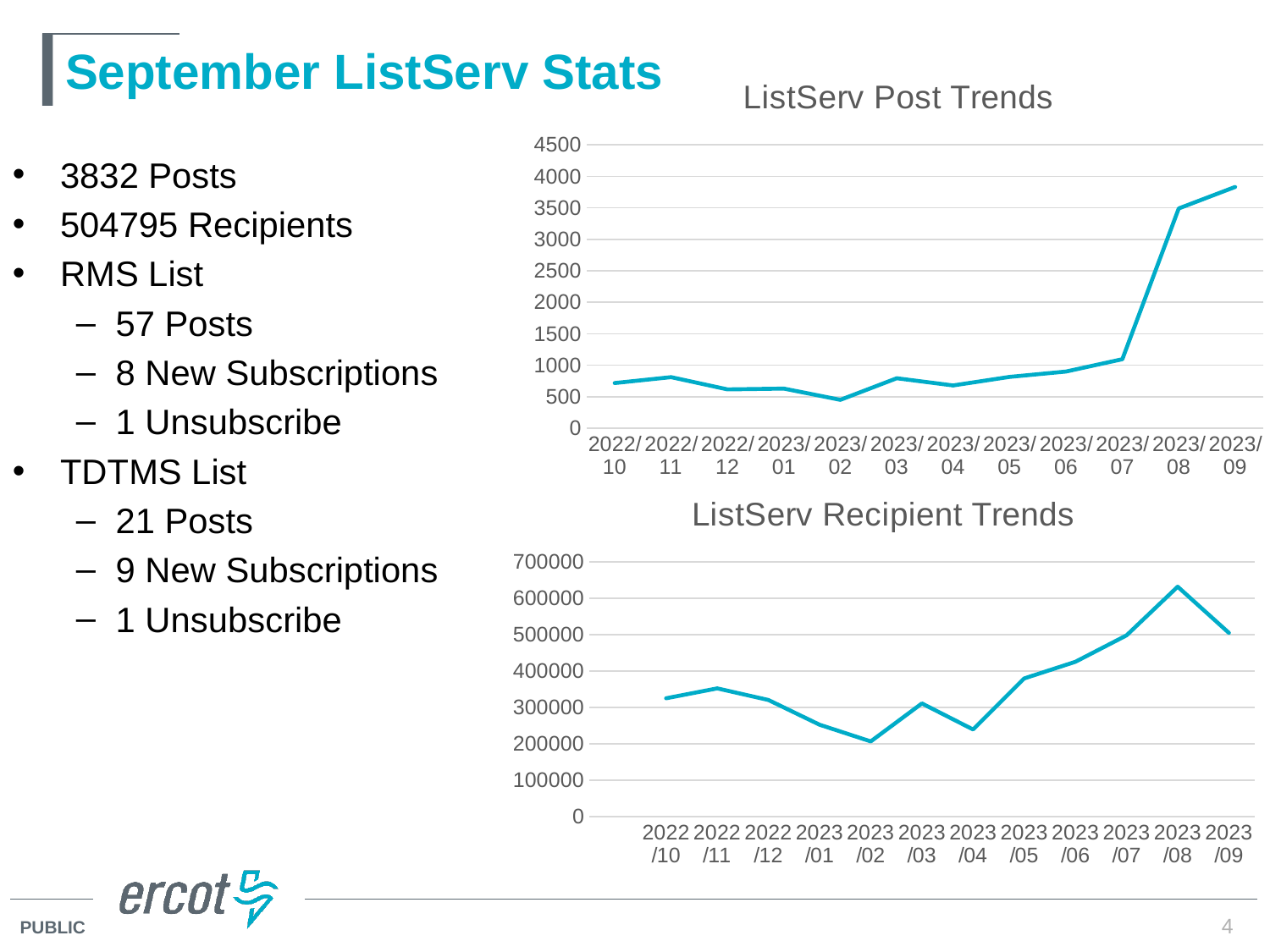
On the "ListServ Post Trends" chart, which month has the lowest value? 2023/02 On the "ListServ Recipient Trends" chart, which is larger, the value for 2023/03 or the value for 2023/04? 2023/03 On the "ListServ Recipient Trends" chart, is the value for 2023/08 greater or less than 600000? greater On the "ListServ Recipient Trends" chart, which month has the highest value? 2023/08 On the "ListServ Post Trends" chart, is the value for 2023/01 greater or less than 1000? less On the "ListServ Post Trends" chart, which month has the highest value? 2023/09 On the "ListServ Recipient Trends" chart, which month has the lowest value? 2023/02 What type of chart is the "ListServ Post Trends" chart? line chart On the "ListServ Post Trends" chart, is the value for 2023/08 greater or less than 3000? greater How many data points are plotted on the "ListServ Post Trends" chart? 12 What is the title of the lower chart on the slide? ListServ Recipient Trends On the "ListServ Post Trends" chart, do the values rise or fall between 2023/07 and 2023/09? rise